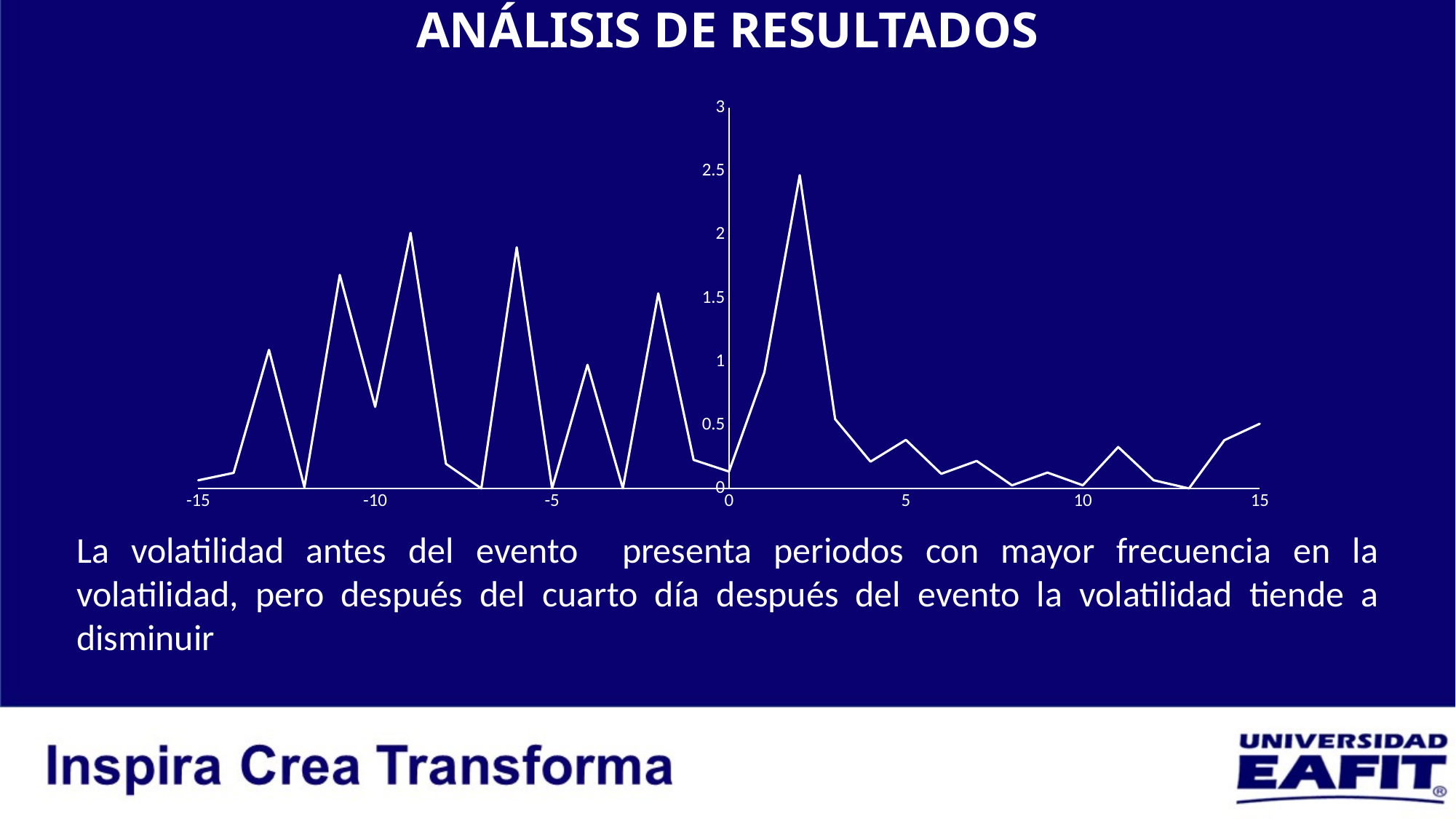
Is the value at x = -11 greater or less than 1.5? greater Is the value at x = 5 greater or less than 0.5? less Is the value at x = -10 greater or less than 0.5? greater Do the values generally rise or fall along the x axis from x = 2 to x = 8? fall At which x-axis value does the line reach its highest point? 2 Which is larger, the value at x = -6 or the value at x = -4? x = -6 What is the highest value shown on the y axis? 3 What kind of chart is shown on the slide? line chart Which is larger, the value at x = 2 or the value at x = -9? x = 2